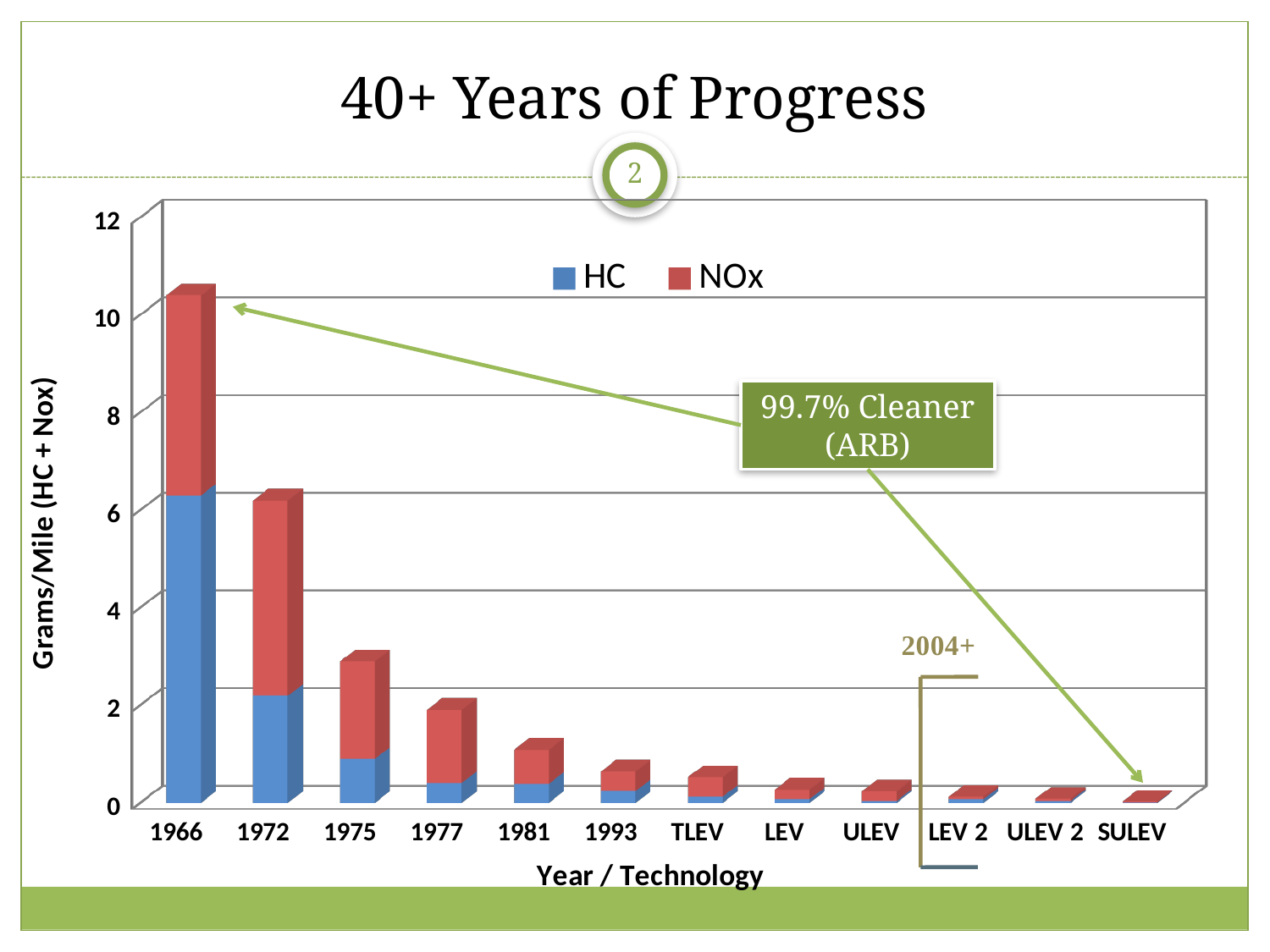
Is the total value for 1972 greater or less than 4? greater Is the total value for 1981 greater or less than 2? less What kind of chart is shown on the slide? Stacked bar chart How many categories are shown along the x axis? 12 Is the total value for 1966 greater or less than 8? greater Which category has the highest total emissions? 1966 Do the total emissions rise or fall moving from 1966 to SULEV along the x axis? fall Which has the larger total, 1972 or 1975? 1972 Which category has the lowest total emissions? SULEV How many series does the legend list? 2 What is the label on the y axis? Grams/Mile (HC + Nox)